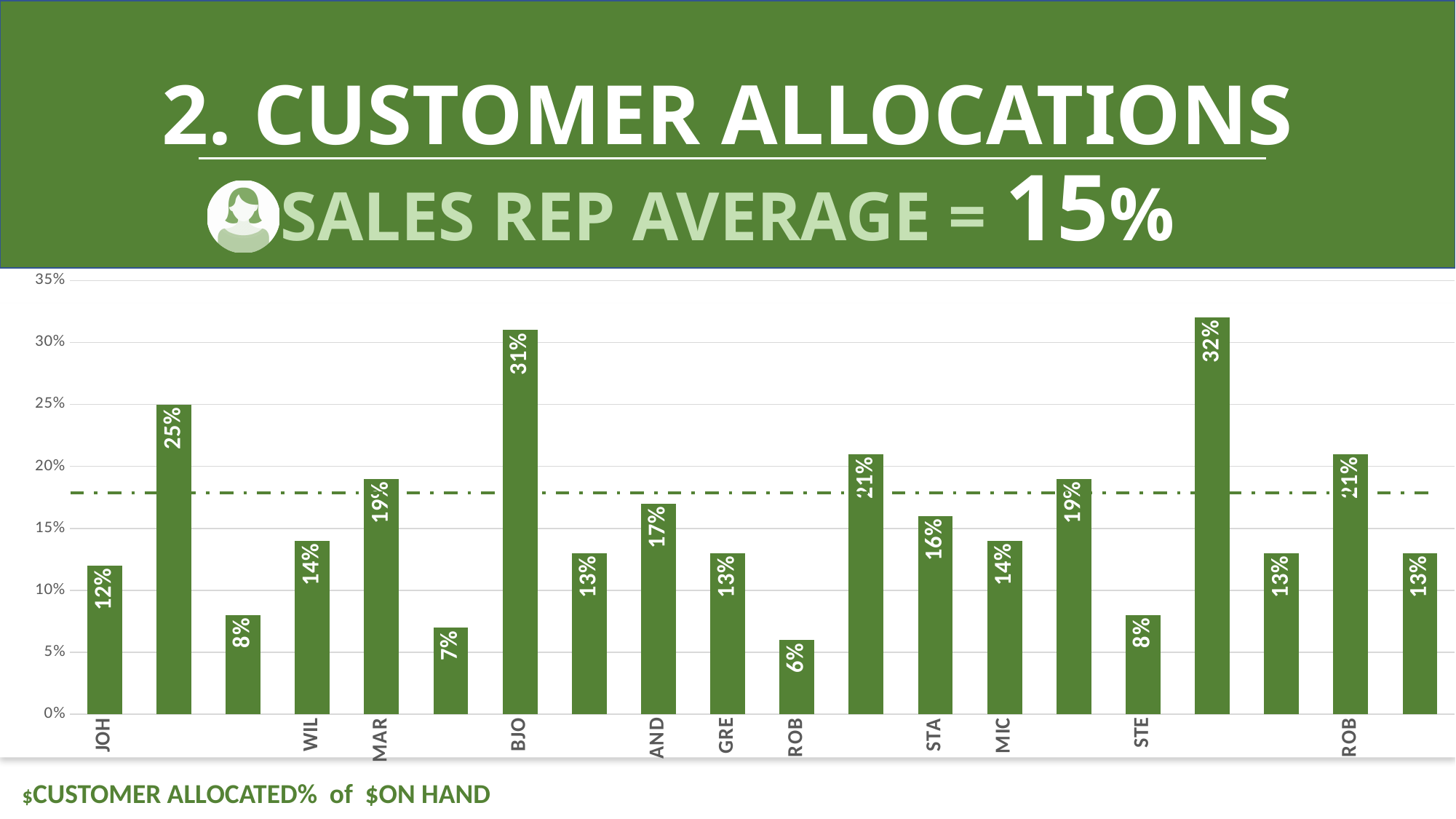
What is the value for BJO? 31% How many bars are plotted in the chart? 20 What is the difference between the values for BJO and JOH? 19 percentage points What is the value for JOH? 12% What is the value for MAR? 19% What is the value for STE? 8% Which has a larger value, MAR or STA? MAR What is the highest value shown by any bar in the chart? 32% What kind of chart is shown on the slide? Bar chart What is the value for AND? 17% What sales rep average is stated in the slide header? 15% What is the value for WIL? 14%